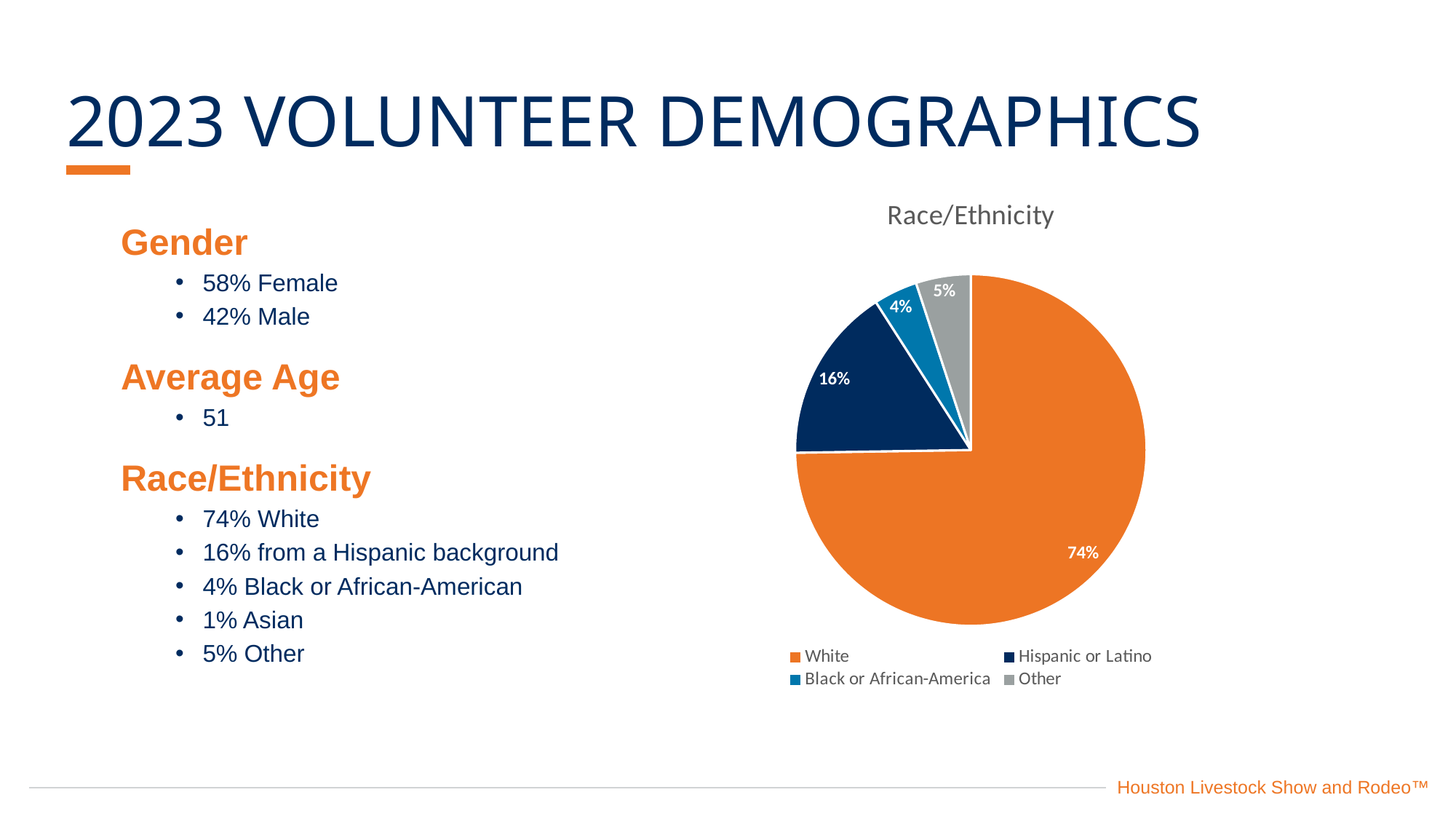
What is the difference in percentage points between the White slice and the Hispanic or Latino slice? 58 How many slices does the pie chart have? 4 Which category has the smallest slice of the pie? Black or African-America What type of chart is shown on the slide? pie chart What percentage of the pie is the Hispanic or Latino slice? 16% What percentage of the pie is the White slice? 74% How many entries does the chart legend list? 4 Which category has the largest slice of the pie? White What percentage of the pie is the Other slice? 5% What is the title of the chart? Race/Ethnicity What percentage of the pie is the Black or African-America slice? 4% Which slice is larger, Other or Black or African-America? Other